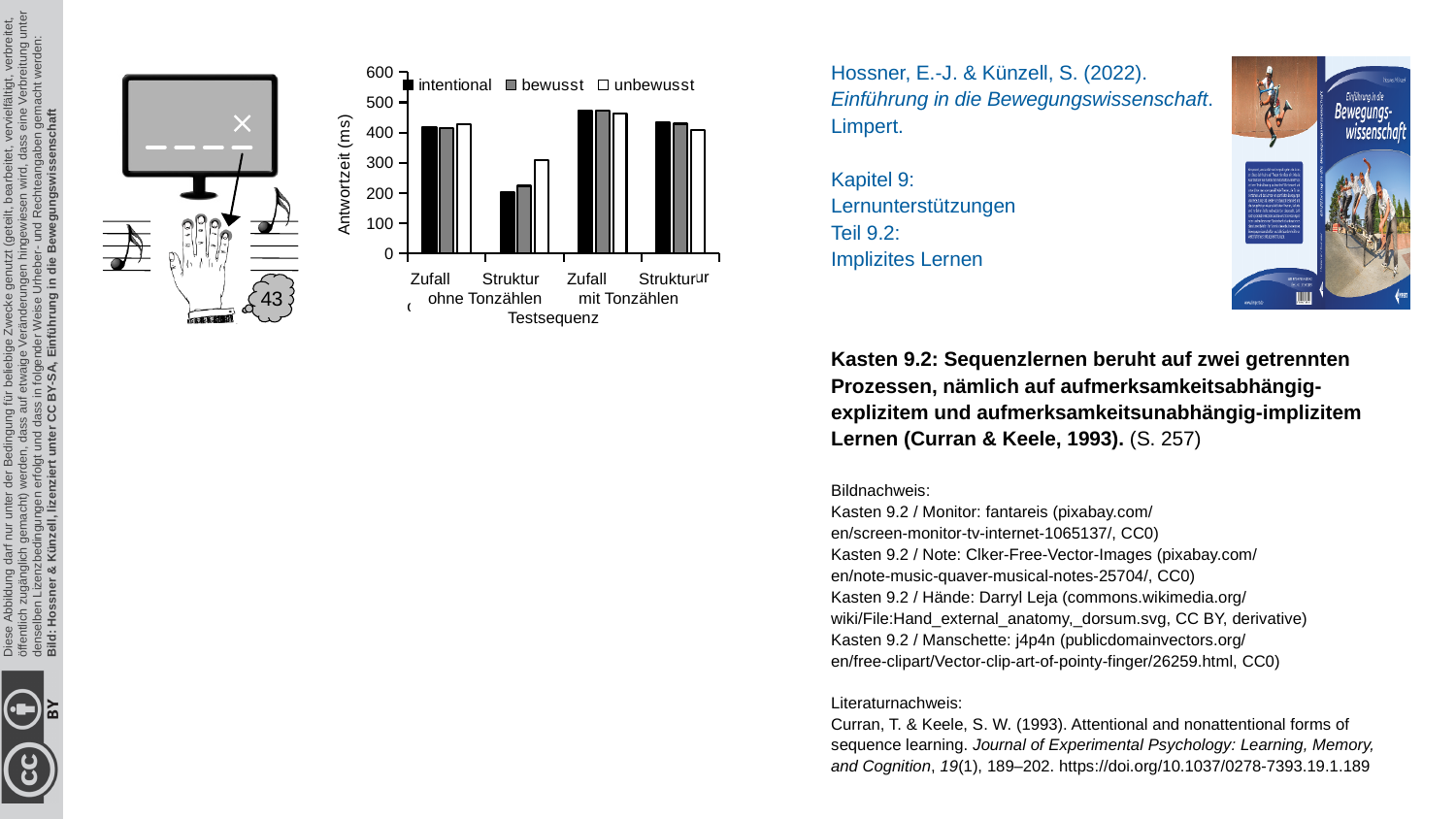
What is the label of the y axis of the chart? Antwortzeit (ms) Which test sequence category has the lowest response times across all series? Struktur ohne Tonzählen Is the value for 'intentional' in the 'Zufall mit Tonzählen' category greater or less than 400? greater What kind of chart is shown on the slide? bar chart Is the value for 'intentional' in the 'Struktur ohne Tonzählen' category greater or less than 300? less Is the value for 'unbewusst' in the 'Struktur ohne Tonzählen' category greater or less than 200? greater For the 'intentional' series, which test sequence category has the highest response time? Zufall mit Tonzählen How many series does the chart legend list? 3 What are the three series named in the chart legend? intentional, bewusst, unbewusst In the 'Struktur ohne Tonzählen' category, which is larger: the value for 'intentional' or the value for 'unbewusst'? unbewusst How many test sequence categories are shown on the x axis of the chart? 4